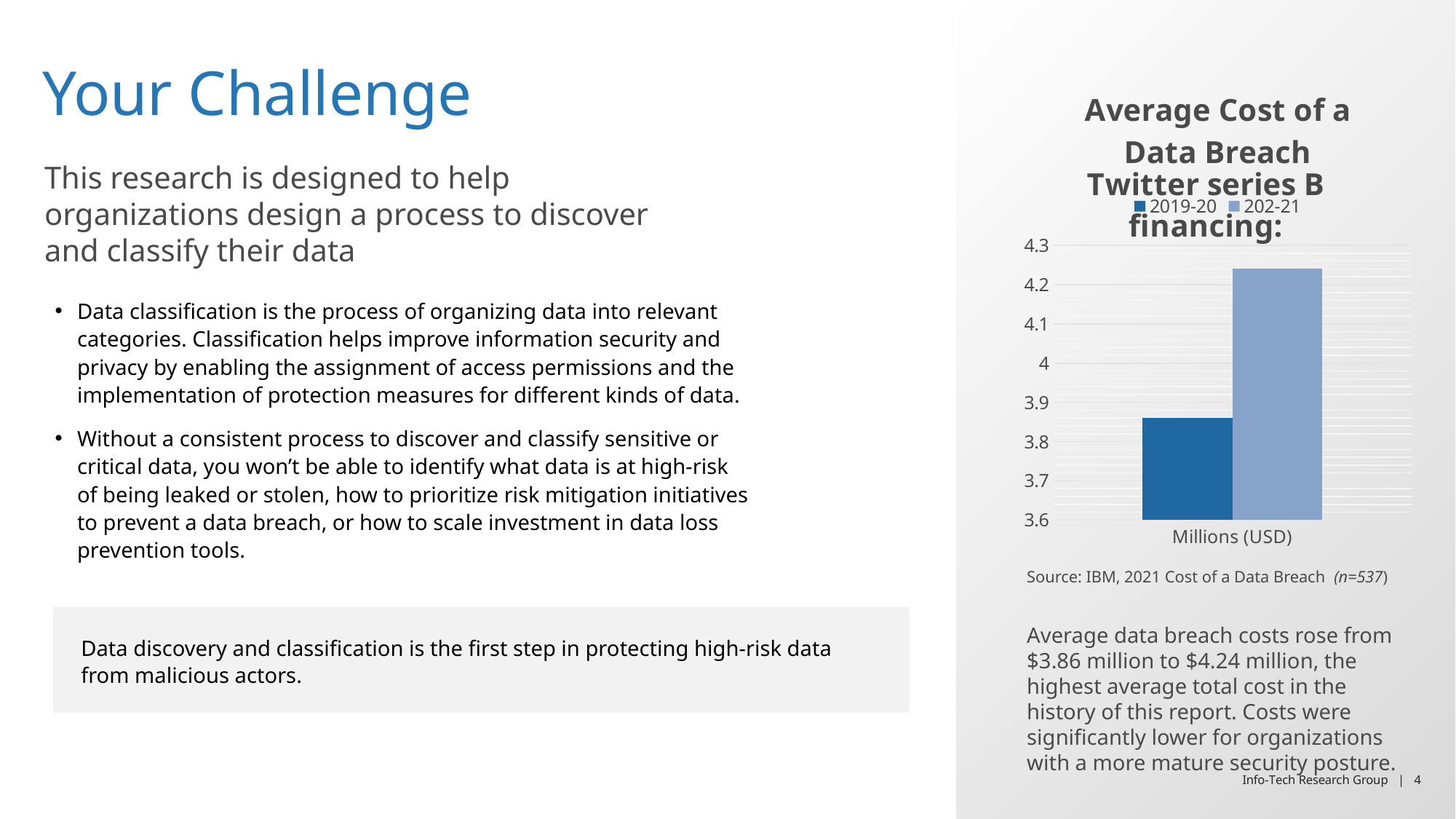
Is the value for the 2019-20 series greater or less than 4? less How many series does the chart's legend list? 2 Is the value for the 202-21 series greater or less than 4.3? less Which series has the taller bar, 2019-20 or 202-21? 202-21 What is the category label shown under the bars on the x axis? Millions (USD) Is the value for the 2019-20 series greater or less than 3.8? greater Which series has the lowest value in the chart? 2019-20 Does the value rise or fall from the 2019-20 series to the 202-21 series? rise Which series has the highest value in the chart? 202-21 What kind of chart is shown on the slide? bar chart How many categories are shown on the chart's x axis? 1